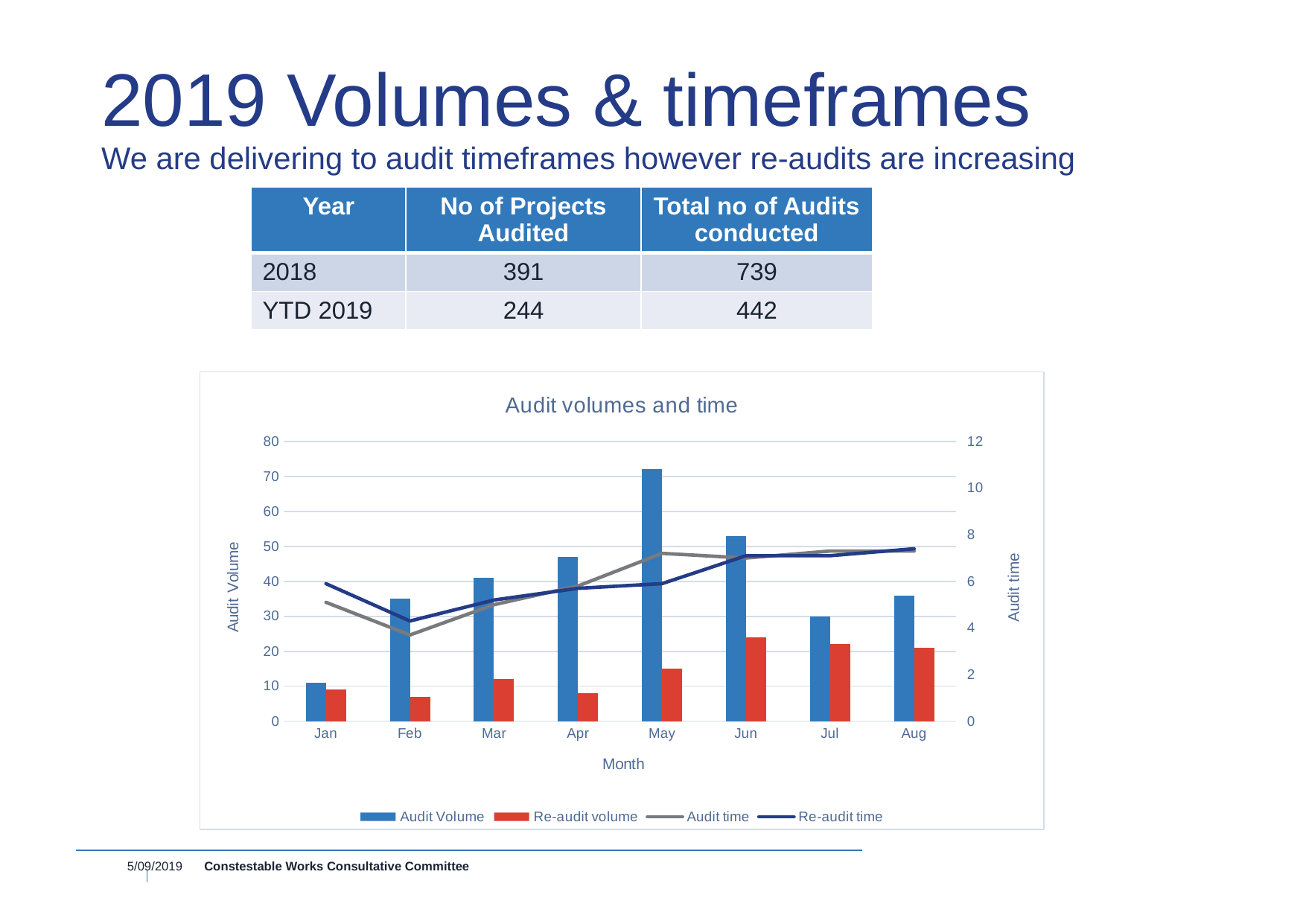
How many months are shown on the x axis of the chart? 8 Does the Re-audit time line generally rise or fall from Feb to Aug? rise Which month has the lowest Audit Volume? Jan Which month has the highest Re-audit volume? Jun Which month has the lowest Re-audit volume? Feb Which month has the highest Audit Volume? May How many series does the chart legend list? 4 What kind of chart is used to show Audit Volume and Re-audit volume? bar chart What is the title of the chart on the slide? Audit volumes and time Is the Audit Volume for May greater or less than 60? greater Which month has the larger Audit Volume, Jun or Apr? Jun Is the Audit Volume for Jan greater or less than 20? less